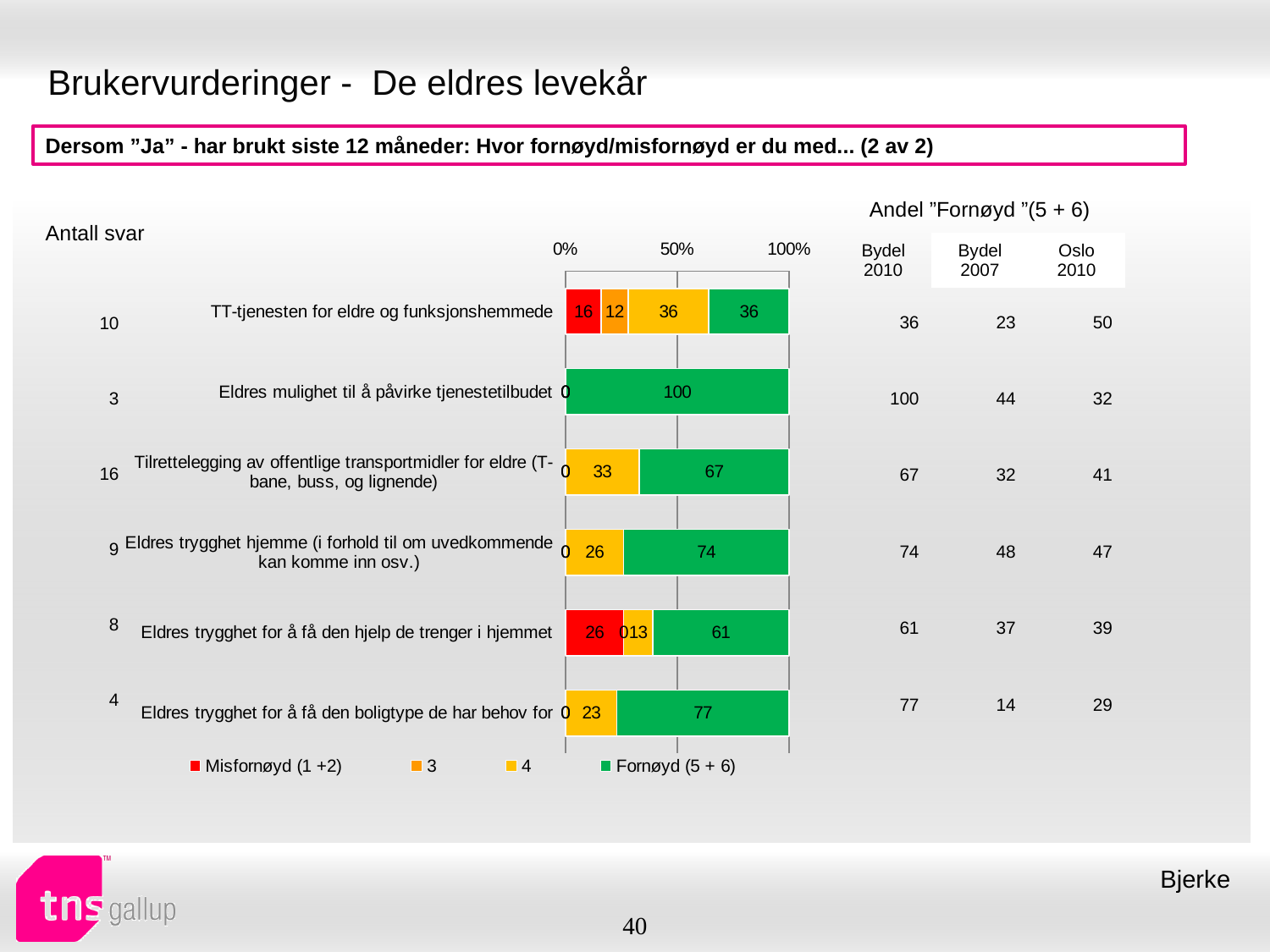
What colour represents Fornøyd (5 + 6) in the legend? Green What is the value of the "4" segment for "Tilrettelegging av offentlige transportmidler for eldre (T-bane, buss, og lignende)"? 33 How many categories are shown in the bar chart? 6 What is the value of the Fornøyd (5 + 6) segment for "TT-tjenesten for eldre og funksjonshemmede"? 36 Which category has the highest Fornøyd (5 + 6) value? Eldres mulighet til å påvirke tjenestetilbudet What kind of chart is shown on the slide? Stacked bar chart What is the difference between the Fornøyd (5 + 6) values for "Eldres trygghet for å få den boligtype de har behov for" and "Tilrettelegging av offentlige transportmidler for eldre"? 10 How many series does the legend list? 4 What is the value of the Misfornøyd (1 +2) segment for "Eldres trygghet for å få den hjelp de trenger i hjemmet"? 26 Which category has the lowest Fornøyd (5 + 6) value? TT-tjenesten for eldre og funksjonshemmede Which has a larger Fornøyd (5 + 6) value: "Eldres trygghet hjemme" or "Eldres trygghet for å få den hjelp de trenger i hjemmet"? Eldres trygghet hjemme What is the total of the stacked bar for "TT-tjenesten for eldre og funksjonshemmede"? 100